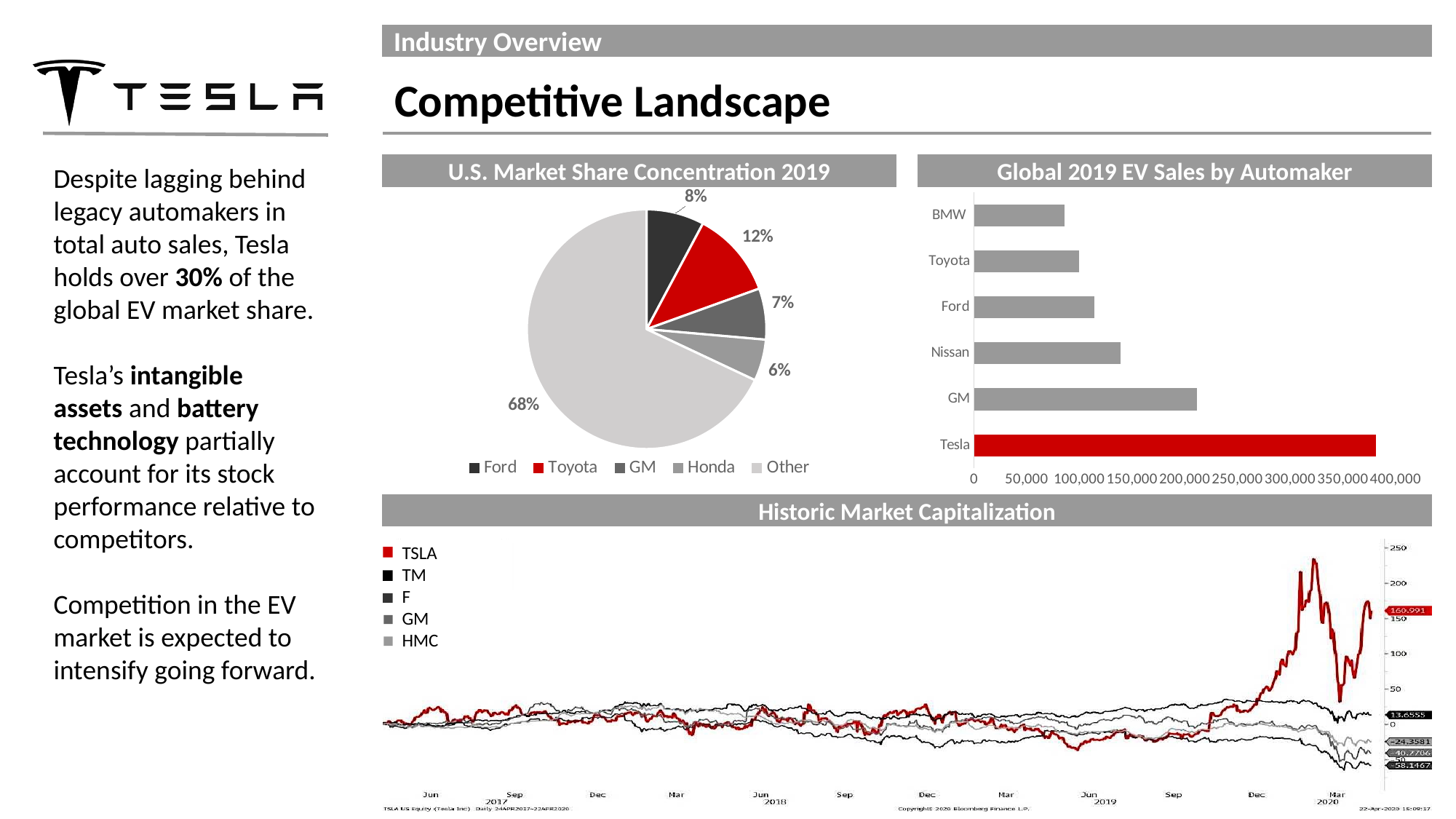
In the U.S. Market Share Concentration 2019 pie chart, which named automaker has the smallest slice? Honda In the Global 2019 EV Sales by Automaker chart, is the value for Nissan greater or less than 150,000? less In the Global 2019 EV Sales by Automaker chart, which automaker has the highest sales? Tesla In the U.S. Market Share Concentration 2019 pie chart, what share does Toyota hold? 12% In the U.S. Market Share Concentration 2019 pie chart, how many percentage points larger is Toyota's share than Ford's? 4% How many series does the legend of the Historic Market Capitalization chart list? 5 In the Global 2019 EV Sales by Automaker chart, which automaker has the lowest sales? BMW In the Global 2019 EV Sales by Automaker chart, which has higher sales, GM or Nissan? GM How many categories does the U.S. Market Share Concentration 2019 pie chart show? 5 In the U.S. Market Share Concentration 2019 pie chart, which category has the largest slice? Other In the U.S. Market Share Concentration 2019 pie chart, what share does Honda hold? 6% In the Global 2019 EV Sales by Automaker chart, is the value for Tesla greater or less than 350,000? greater